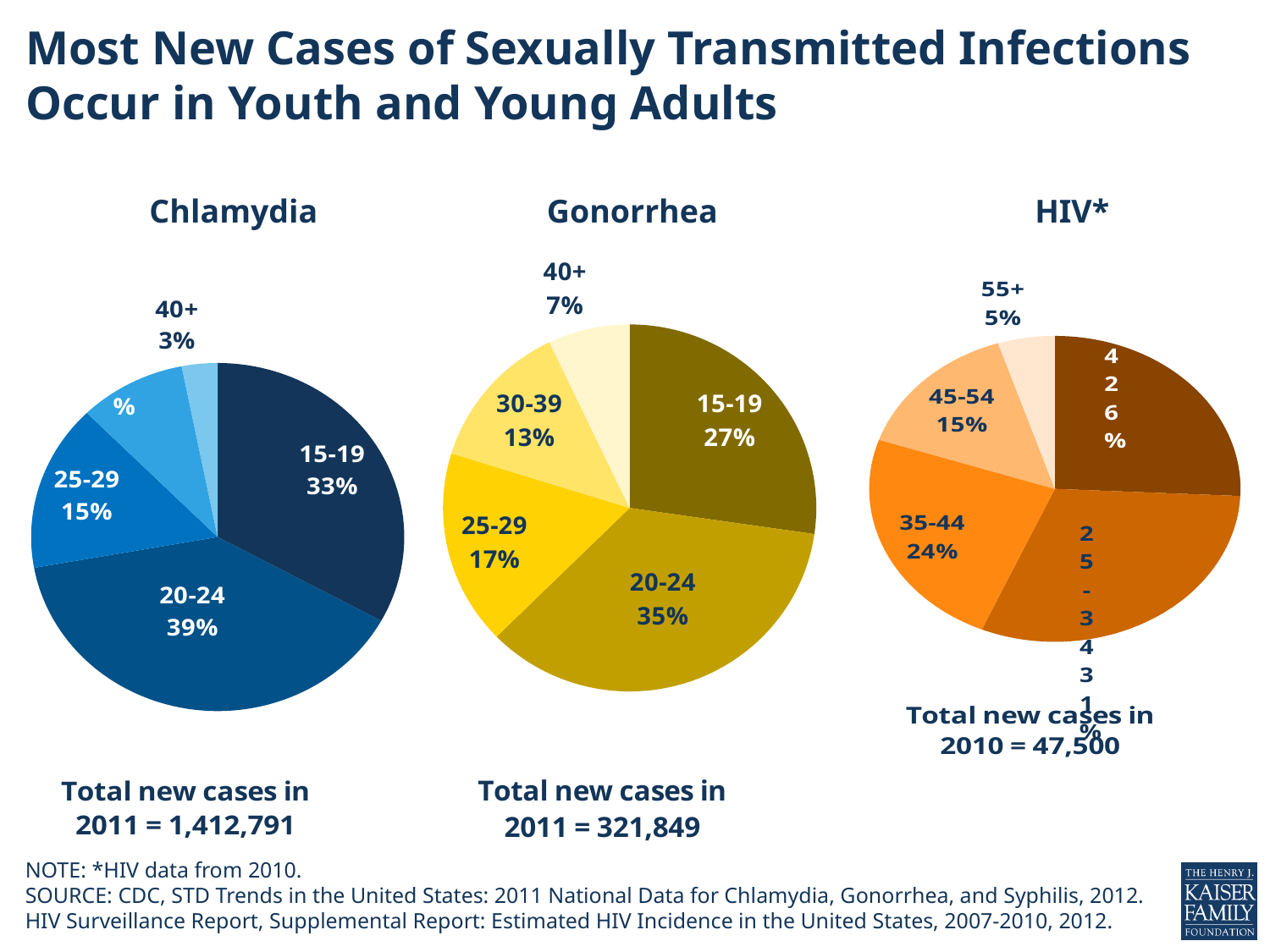
Which is larger: the 15-19 share in the Chlamydia chart or the 15-19 share in the Gonorrhea chart? Chlamydia According to the text under the Gonorrhea pie chart, what was the total number of new cases in 2011? 321,849 In the Chlamydia pie chart, which age group has the largest share of new cases? 20-24 In the Chlamydia pie chart, what share of new cases is in the 20-24 age group? 39% In the HIV* pie chart, what share of new cases is in the 35-44 age group? 24% How many age-group slices does the Gonorrhea pie chart have? 5 What type of chart is used for the Chlamydia, Gonorrhea and HIV* data on this slide? Pie chart In the Chlamydia pie chart, what share of new cases is in the 40+ age group? 3% In the Gonorrhea pie chart, which age group has the smallest share of new cases? 40+ In the Gonorrhea pie chart, what share of new cases is in the 15-19 age group? 27% In the Gonorrhea pie chart, how many percentage points larger is the 20-24 share than the 25-29 share? 18 percentage points In the HIV* pie chart, what share of new cases is in the 55+ age group? 5%